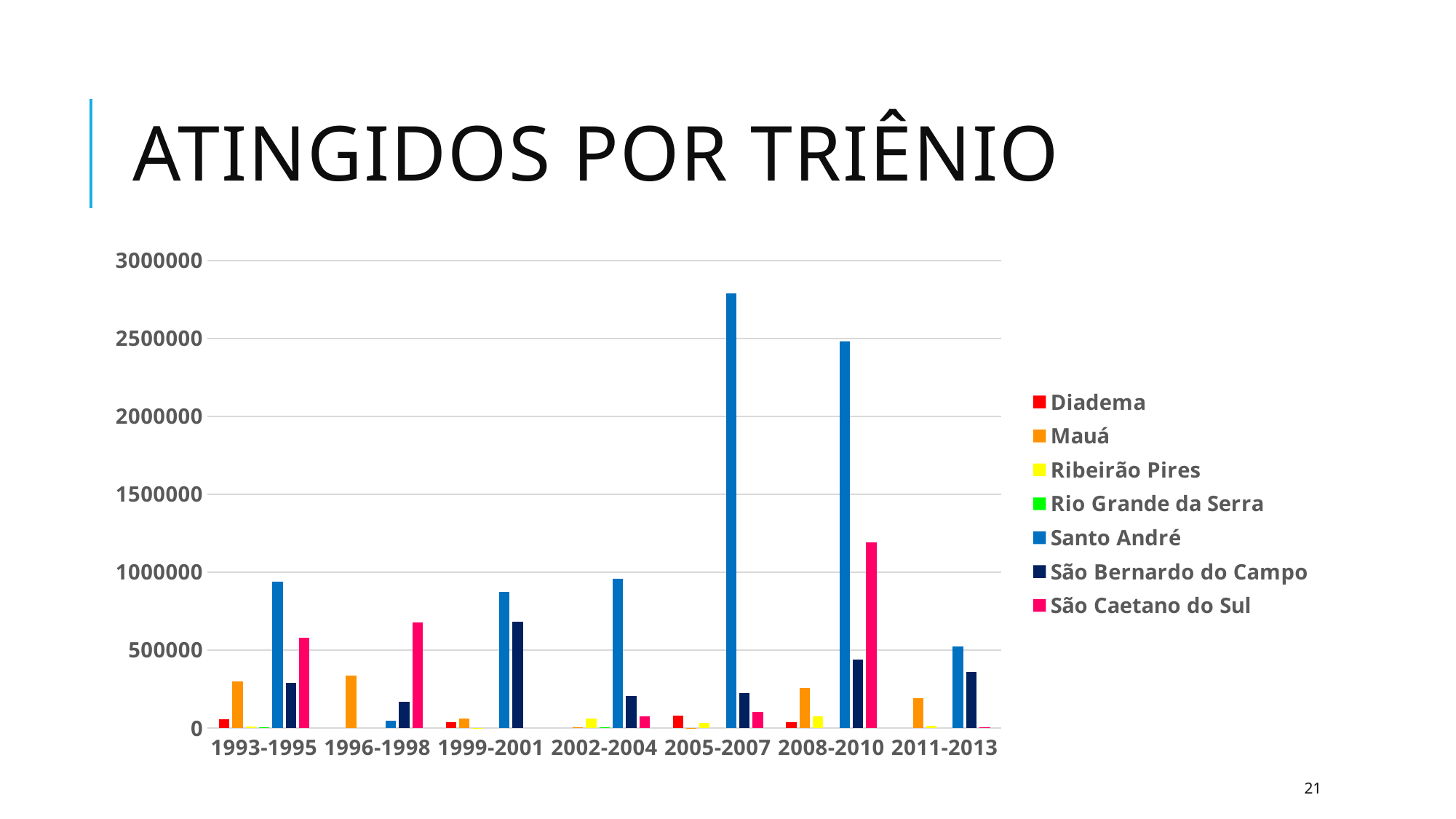
Is the value for Santo André in 2005-2007 greater or less than 2500000? greater In which triennium is the Santo André bar the lowest? 1996-1998 Is the value for São Caetano do Sul in 2008-2010 greater or less than 1000000? greater Which is larger: São Caetano do Sul in 1993-1995 or São Caetano do Sul in 2008-2010? São Caetano do Sul in 2008-2010 What kind of chart is shown on the slide? bar chart Which series has the tallest bar in the whole chart? Santo André Which series is shown in pink in the legend? São Caetano do Sul Is the value for Santo André in 1993-1995 greater or less than 1000000? less How many triennia (categories) are shown on the x axis? 7 What is the title of the chart slide? ATINGIDOS POR TRIÊNIO In which triennium does Santo André reach its highest value? 2005-2007 How many series does the legend list? 7